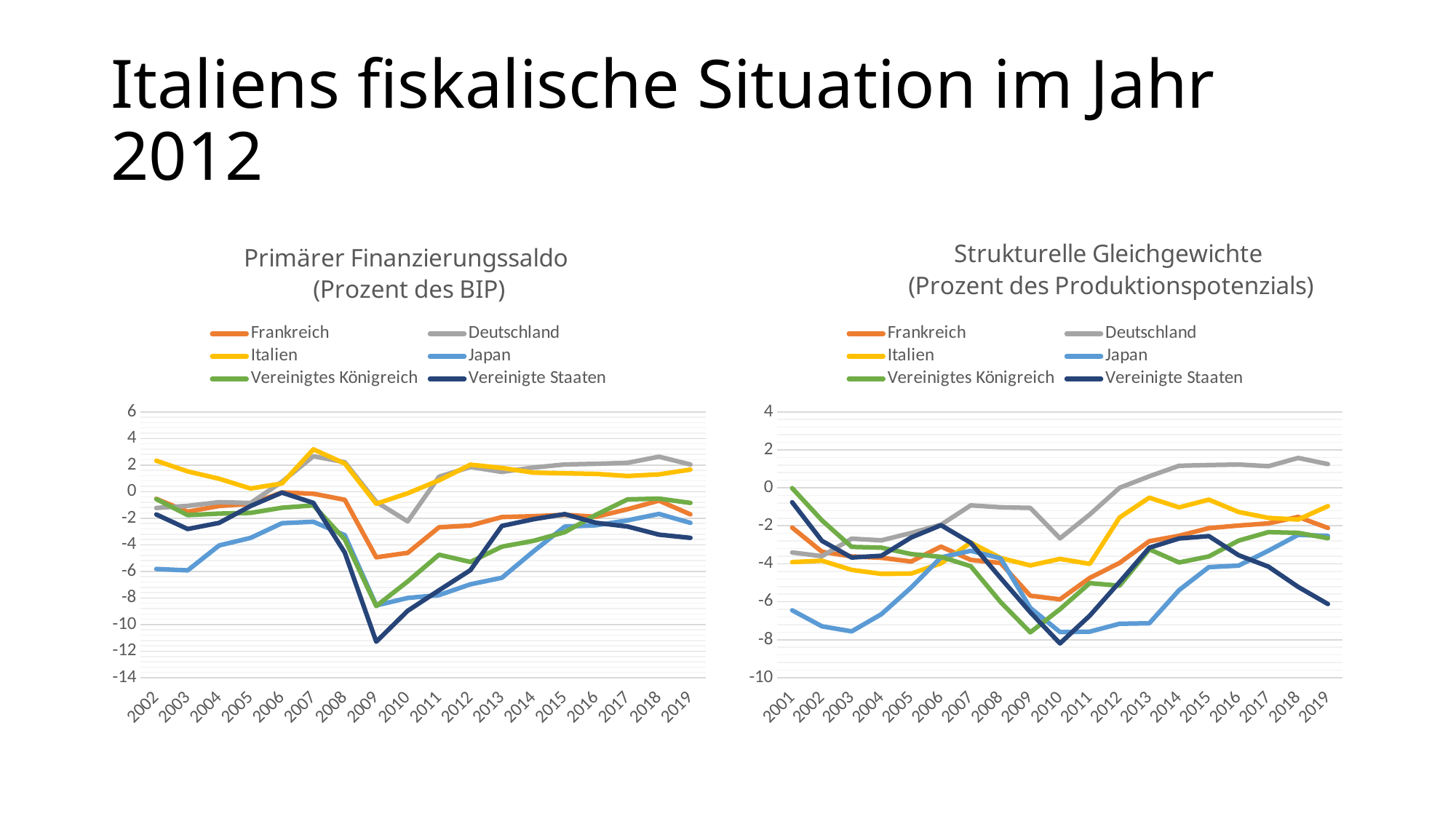
In the "Strukturelle Gleichgewichte" chart, is the value for Deutschland in 2018 greater or less than 0? greater In the "Primärer Finanzierungssaldo" chart, which series has the lowest value in 2009? Vereinigte Staaten In the "Strukturelle Gleichgewichte" chart, does the Vereinigte Staaten line rise or fall from 2015 to 2019? fall In the "Primärer Finanzierungssaldo" chart, is the value for Vereinigte Staaten in 2009 greater or less than -10? less In the "Strukturelle Gleichgewichte" chart, is the value for Japan in 2003 greater or less than -6? less In the "Strukturelle Gleichgewichte" chart, which series has the highest value in 2019? Deutschland How many years are shown on the x axis of the "Strukturelle Gleichgewichte" chart? 19 How many years are shown on the x axis of the "Primärer Finanzierungssaldo" chart? 18 In the "Strukturelle Gleichgewichte" chart, which is larger in 2009: Deutschland or Vereinigtes Königreich? Deutschland What kind of chart is the "Primärer Finanzierungssaldo" chart on the left? line chart How many series does the legend of the "Strukturelle Gleichgewichte" chart list? 6